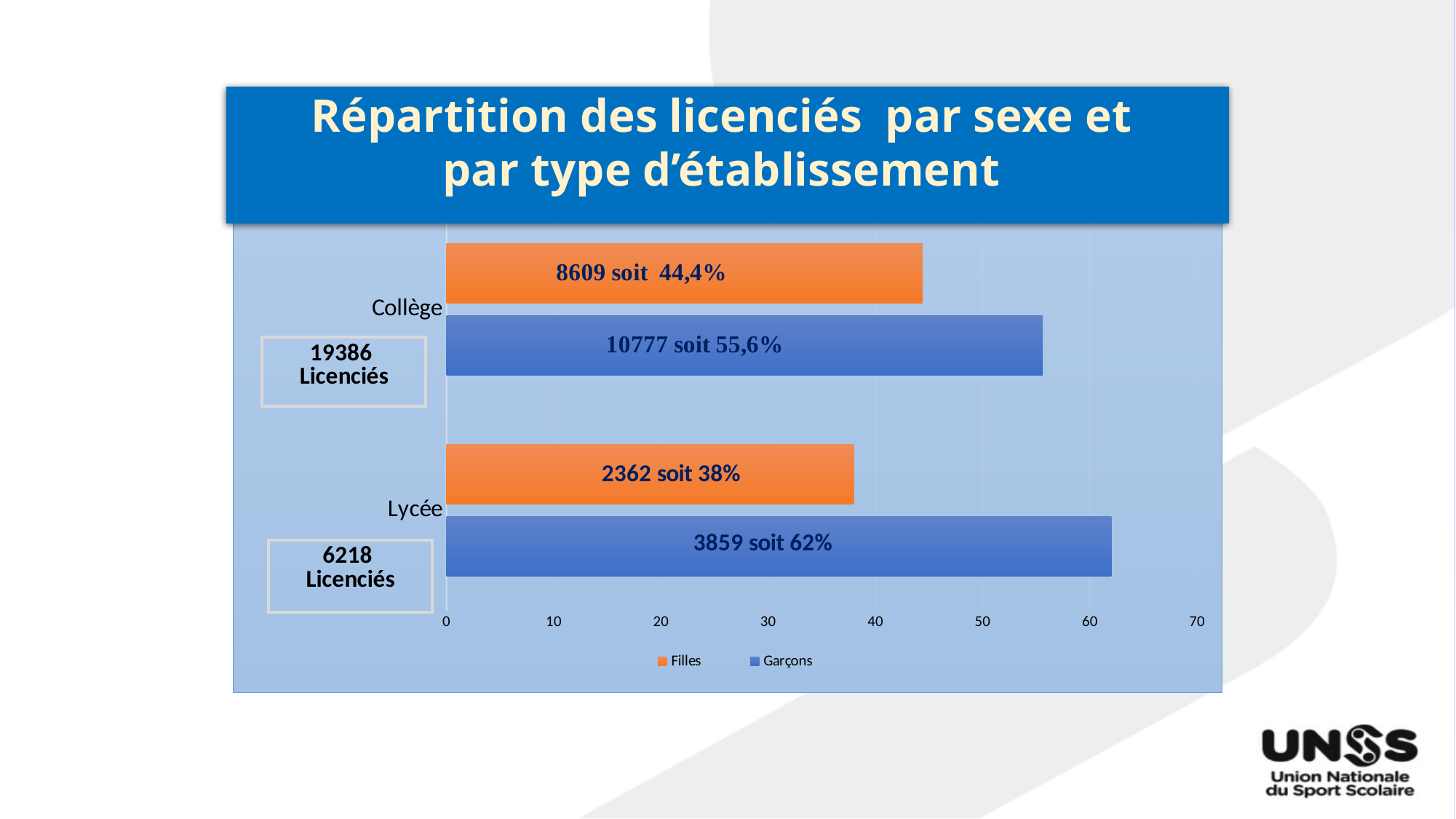
Which series has the longer bar for Lycée, Filles or Garçons? Garçons What is the data label on the Filles bar for Collège? 8609 soit 44,4% How many categories are shown on the vertical axis? 2 Is the Filles bar for Collège greater or less than 40 on the axis? greater How many series does the legend list? 2 What is the data label on the Garçons bar for Lycée? 3859 soit 62% What is the difference in percentage points between the Garçons and Filles shares for Lycée? 24 What is the data label on the Garçons bar for Collège? 10777 soit 55,6% What is the data label on the Filles bar for Lycée? 2362 soit 38% Which category has the longer Garçons bar, Collège or Lycée? Lycée What kind of chart is shown on the slide? bar chart What is the title of the chart? Répartition des licenciés par sexe et par type d'établissement